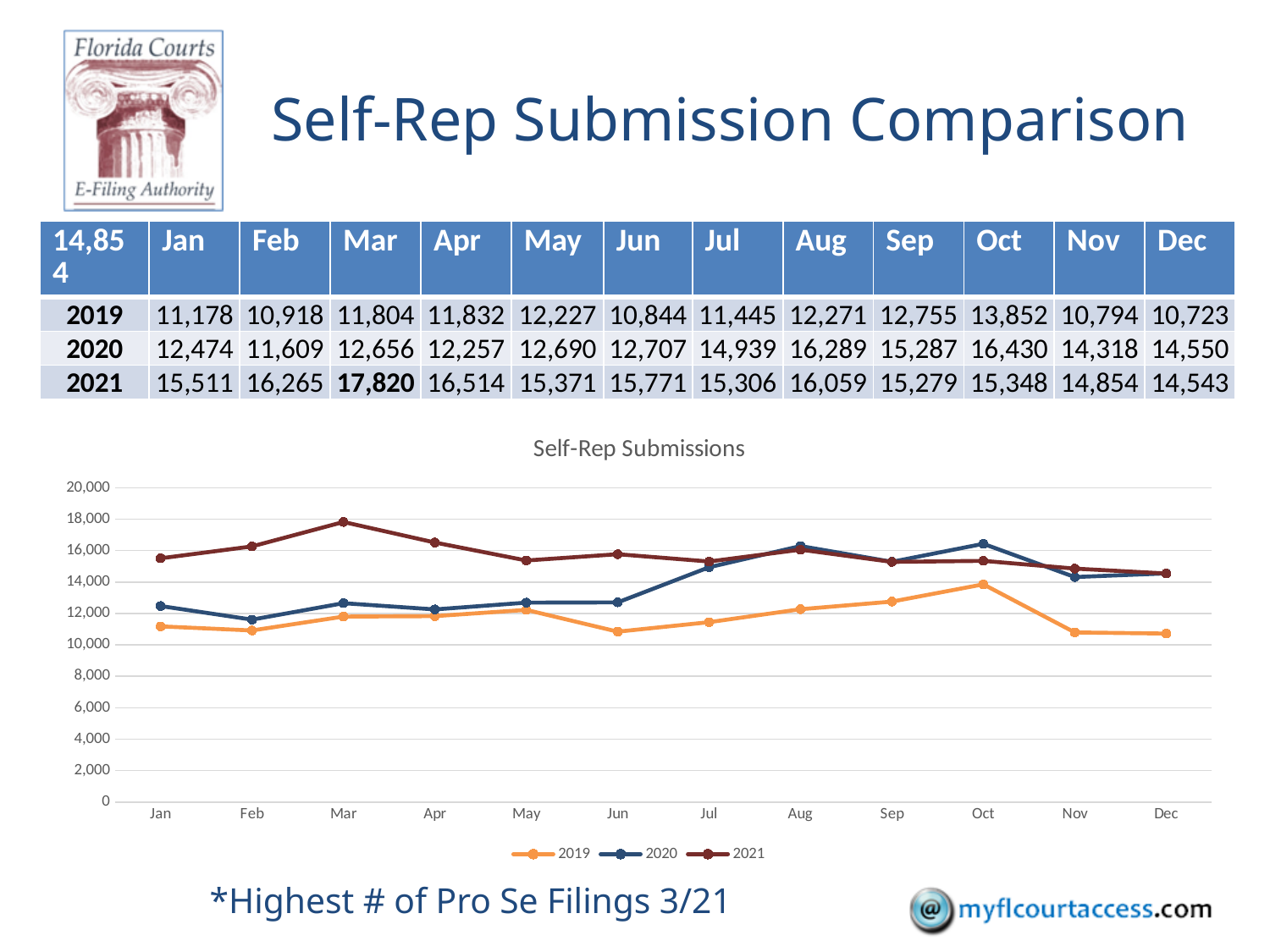
What is the title of the chart? Self-Rep Submissions In which month is the 2020 series highest? Oct What is the value for 2021 in March? 17,820 Do the 2019 values rise or fall from October to December? fall In which month is the 2019 series lowest? Dec How many series does the chart legend list? 3 What is the difference between the 2021 and 2020 values in March? 5,164 How many months are plotted along the x axis of the chart? 12 Which is larger in January, the 2020 value or the 2019 value? 2020 In which month is the 2021 series highest? Mar What is the value for 2019 in October? 13,852 What type of chart is shown on the slide? line chart